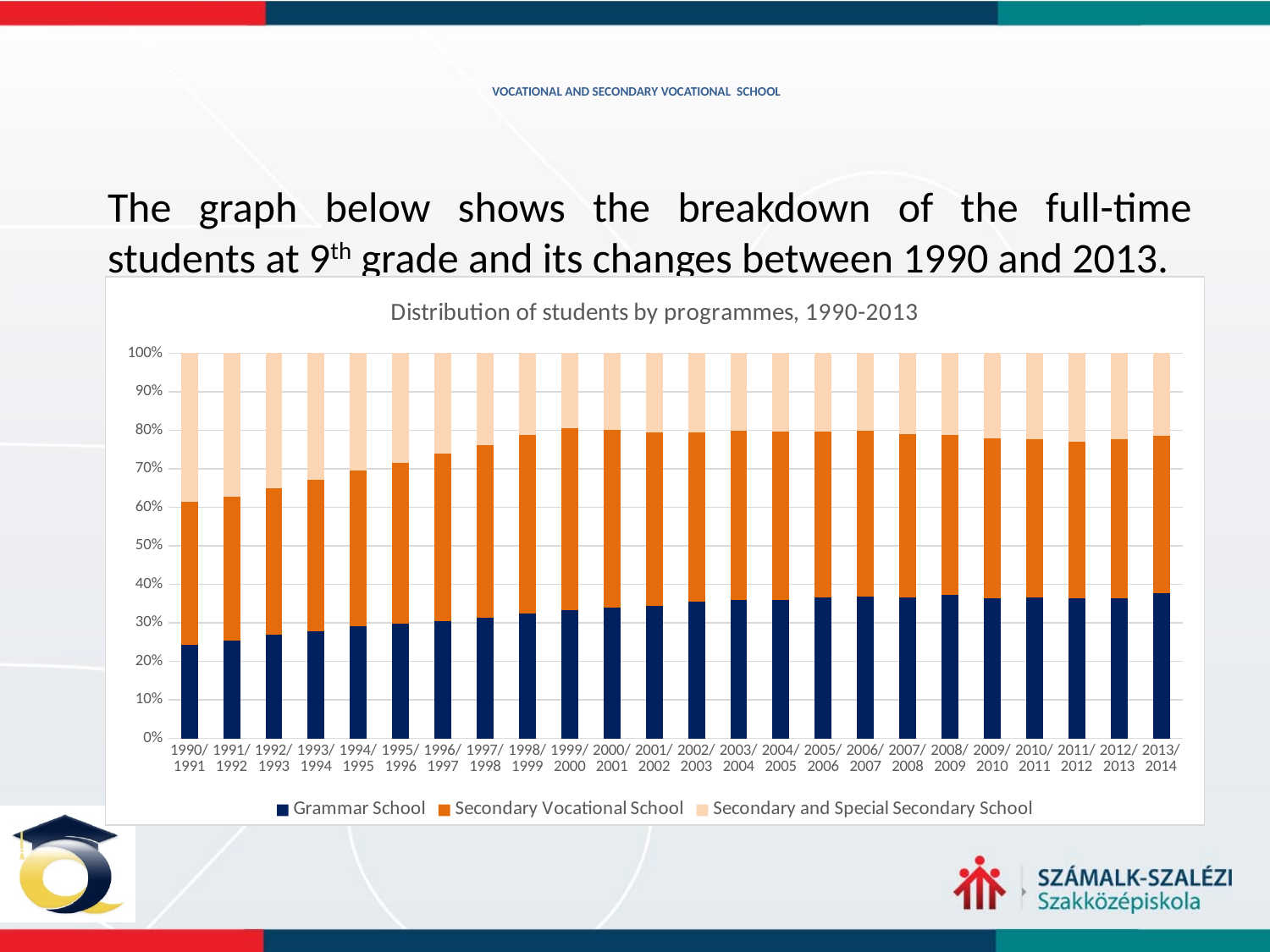
Which series are listed in the legend? Grammar School, Secondary Vocational School, Secondary and Special Secondary School Does the Grammar School share rise or fall from 1990/1991 to 2013/2014? Rise What is the title of the chart? Distribution of students by programmes, 1990-2013 Is the Grammar School value for 1999/2000 greater or less than 30%? greater Which school year has the lowest Grammar School share? 1990/1991 Is the Grammar School value for 1990/1991 greater or less than 30%? less How many series does the legend list? 3 How many school years (categories) are shown on the x axis? 24 Which is larger, the Grammar School share in 1990/1991 or in 2013/2014? 2013/2014 What kind of chart is shown on the slide? Stacked bar chart Is the Grammar School value for 2013/2014 greater or less than 30%? greater Which school year has the largest Secondary and Special Secondary School share? 1990/1991